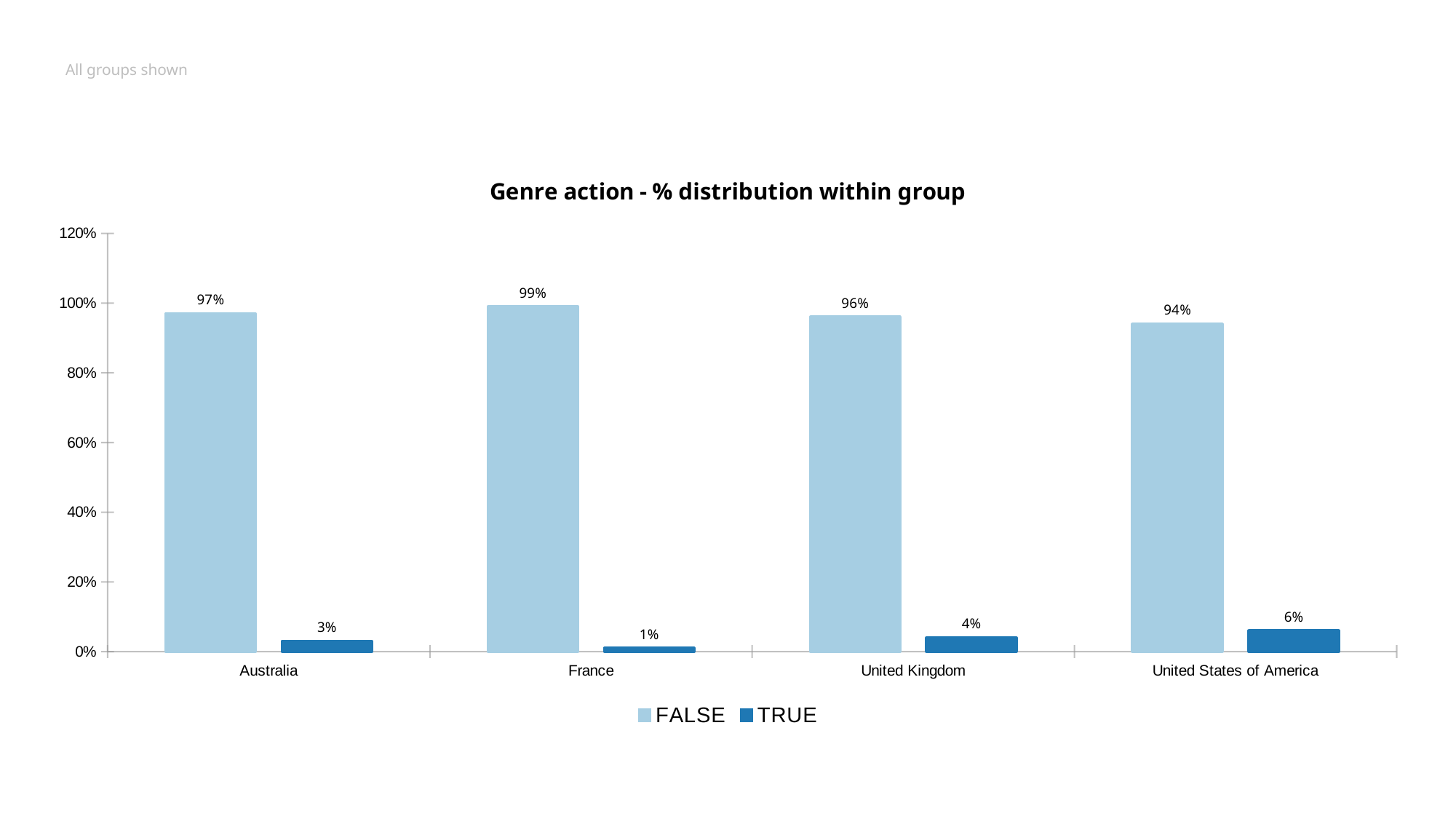
What is the FALSE value for United Kingdom? 96% Which is larger, the TRUE value for Australia or the TRUE value for United Kingdom? United Kingdom What is the TRUE value for France? 1% How many countries are shown on the x axis? 4 Is the FALSE value for France greater or less than 80%? greater Which country has the highest TRUE value? United States of America What is the difference between the FALSE and TRUE values for United Kingdom? 92% How many series does the legend list? 2 What is the TRUE value for United States of America? 6% What is the FALSE value for Australia? 97% What kind of chart is shown? bar chart Which country has the lowest FALSE value? United States of America